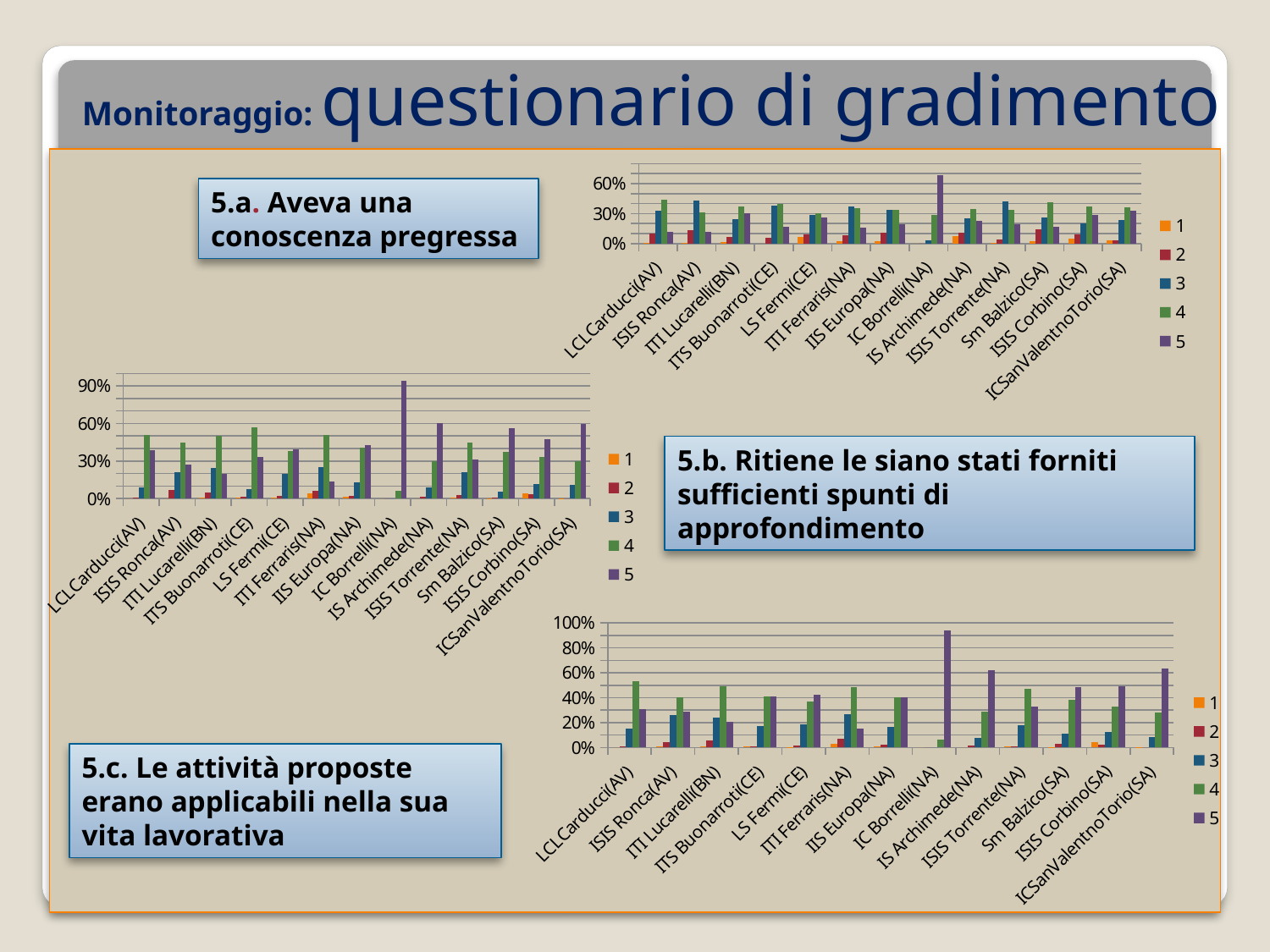
How many categories (schools) are shown on the x axis of the middle-left chart? 13 What kind of chart is the chart in the top-right of the slide? bar chart In the bottom-right chart, which category has the tallest bar? IC Borrelli(NA) In the middle-left chart, is the value of series 5 for IC Borrelli(NA) greater or less than 60%? greater How many series does the legend of the bottom-right chart list? 5 In the middle-left chart, for LCLCarducci(AV), which is larger: series 3 or series 4? 4 In the bottom-right chart, is the value of series 4 for LCLCarducci(AV) greater or less than 40%? greater What is the highest value shown on the y axis of the bottom-right chart? 100% In the bottom-right chart, is the value of series 1 for ISIS Ronca(AV) greater or less than 20%? less In the bottom-right chart, for IC Borrelli(NA), which is larger: series 4 or series 5? 5